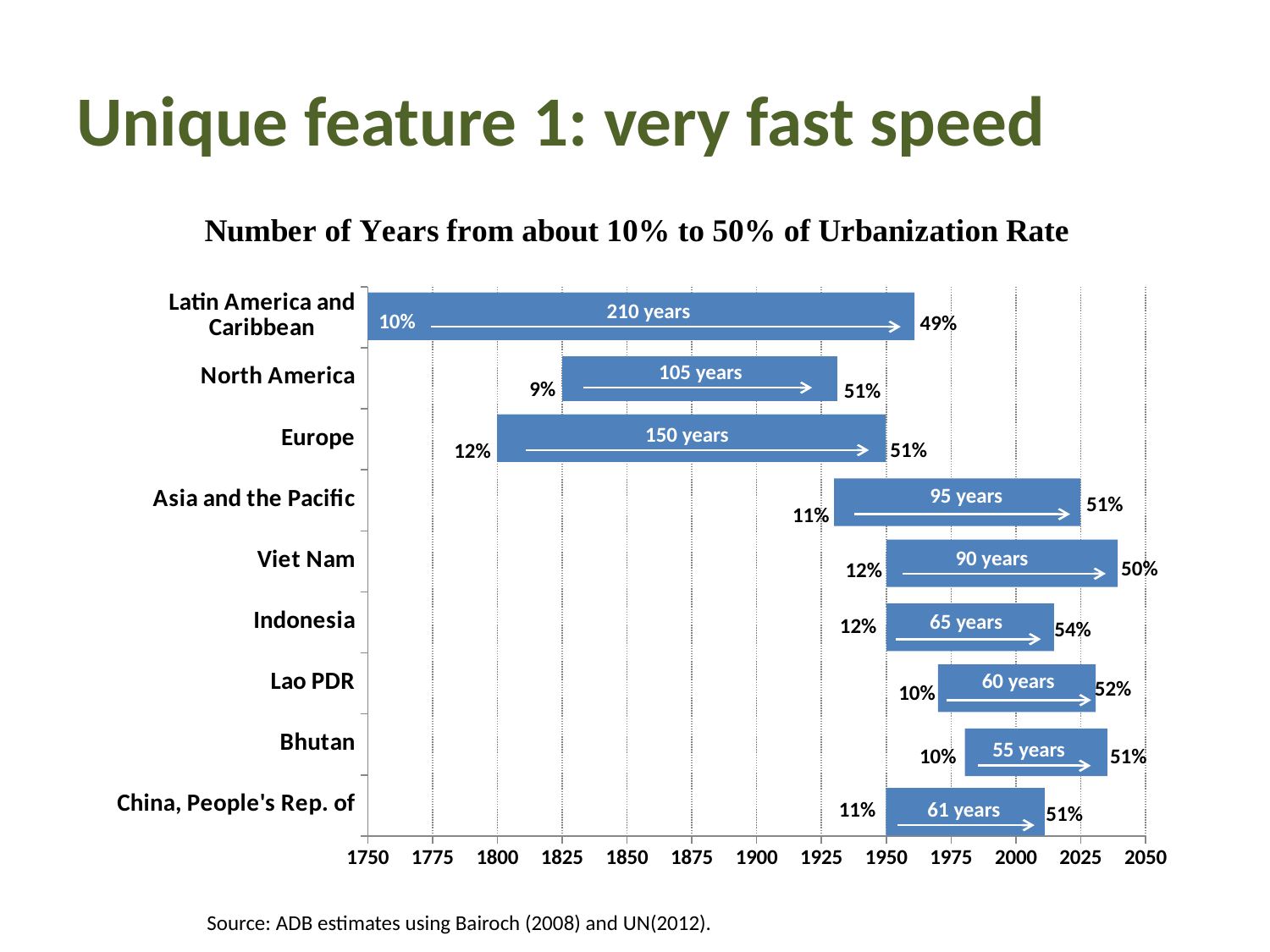
Which region or country took the most years to go from about 10% to 50% urbanization? Latin America and Caribbean How many more years did North America take than Asia and the Pacific? 10 years Which region or country took the fewest years to go from about 10% to 50% urbanization? Bhutan How many years did Viet Nam take to go from about 10% to 50% urbanization? 90 years How many years did Europe take to go from about 10% to 50% urbanization? 150 years What kind of chart is shown on the slide? bar chart Which took more years to urbanize from about 10% to 50%: Indonesia or Lao PDR? Indonesia What is the title of the chart? Number of Years from about 10% to 50% of Urbanization Rate How many years did Latin America and Caribbean take to go from about 10% to 50% urbanization? 210 years What was the starting urbanization rate shown for North America? 9% What urbanization rate did Indonesia reach at the end of its bar? 54% How many regions or countries are listed on the chart? 9